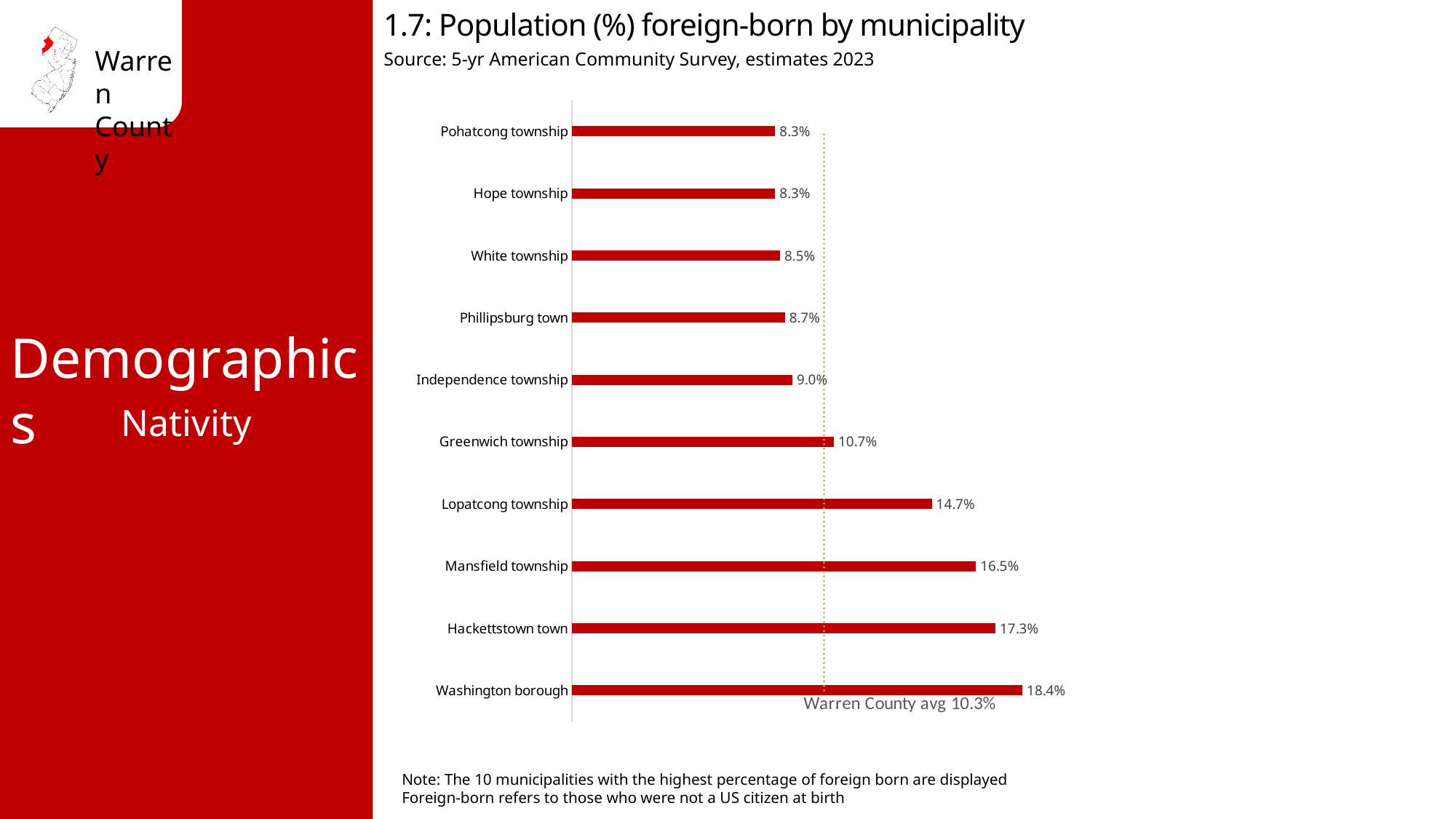
What is the foreign-born percentage for Washington borough? 18.4% Which municipality has the highest foreign-born percentage? Washington borough What kind of chart is shown on the slide? Bar chart What is the foreign-born percentage for Phillipsburg town? 8.7% What is the difference in foreign-born percentage between Hackettstown town and Mansfield township? 0.8% What is the Warren County average foreign-born percentage shown by the dotted line? 10.3% What is the source of the data in the chart? 5-yr American Community Survey, estimates 2023 What is the difference in foreign-born percentage between Washington borough and Pohatcong township? 10.1% What is the foreign-born percentage for Greenwich township? 10.7% How many municipalities are shown in the chart? 10 Which has a higher foreign-born percentage, White township or Mansfield township? Mansfield township Which has a higher foreign-born percentage, Lopatcong township or Independence township? Lopatcong township